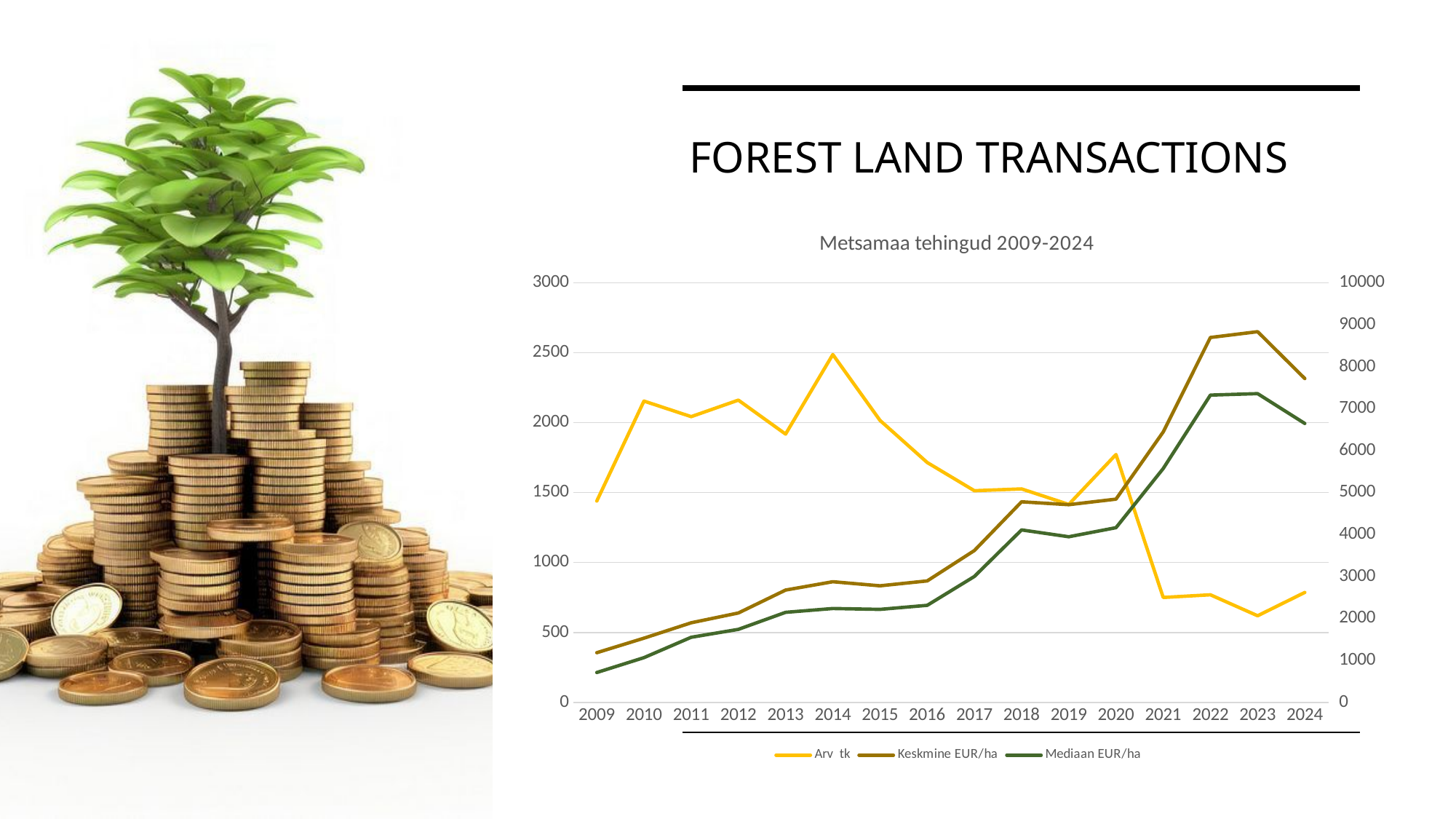
What is the title of the chart? Metsamaa tehingud 2009-2024 In which year is the Arv tk series lowest? 2023 In which year is the Arv tk series highest? 2014 What kind of chart is shown on the slide? line chart Is the Keskmine EUR/ha value for 2023 greater or less than 8000 on the right axis? greater How many years are shown on the x axis? 16 How many series does the legend list? 3 In which year is the Keskmine EUR/ha series lowest? 2009 Does the Arv tk series rise or fall from 2020 to 2023? fall Which is larger in 2022, Keskmine EUR/ha or Mediaan EUR/ha? Keskmine EUR/ha Is the Arv tk value for 2014 greater or less than 2000 on the left axis? greater Which colour is the Arv tk line? yellow